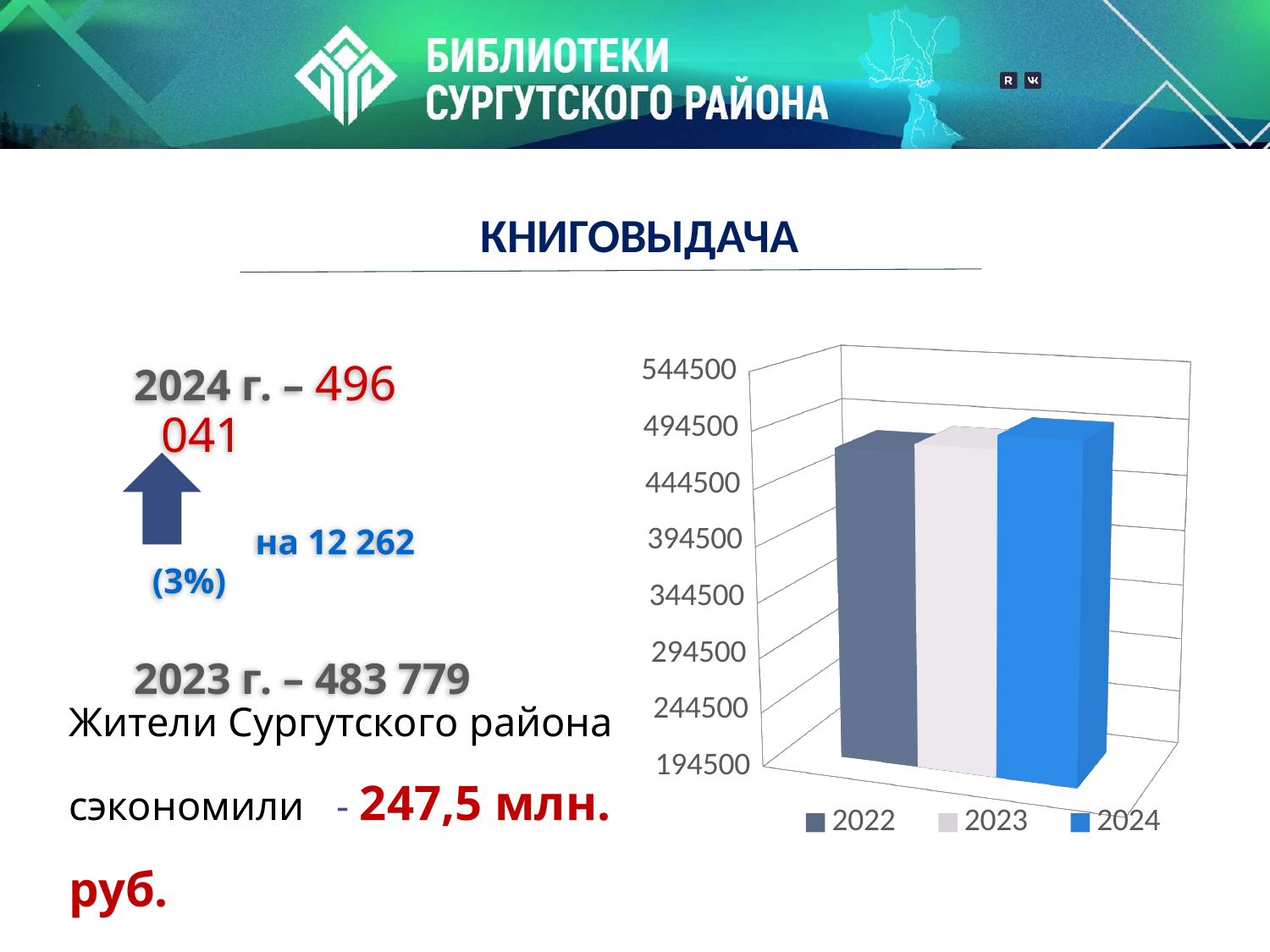
Which year has the tallest bar in the chart? 2024 Is the value for 2023 greater or less than 394500? greater Is the value for 2024 greater or less than 544500? less How many series does the chart legend list? 3 Do the bar values rise or fall from 2022 to 2024? rise According to the slide, what is the book lending value for 2023? 483 779 According to the slide, what is the book lending value for 2024? 496 041 How many bars are plotted in the chart? 3 What kind of chart is shown on the slide? bar chart What is the title of the slide above the chart? КНИГОВЫДАЧА Is the value for 2022 greater or less than 444500? greater Which years are listed in the chart legend? 2022, 2023, 2024